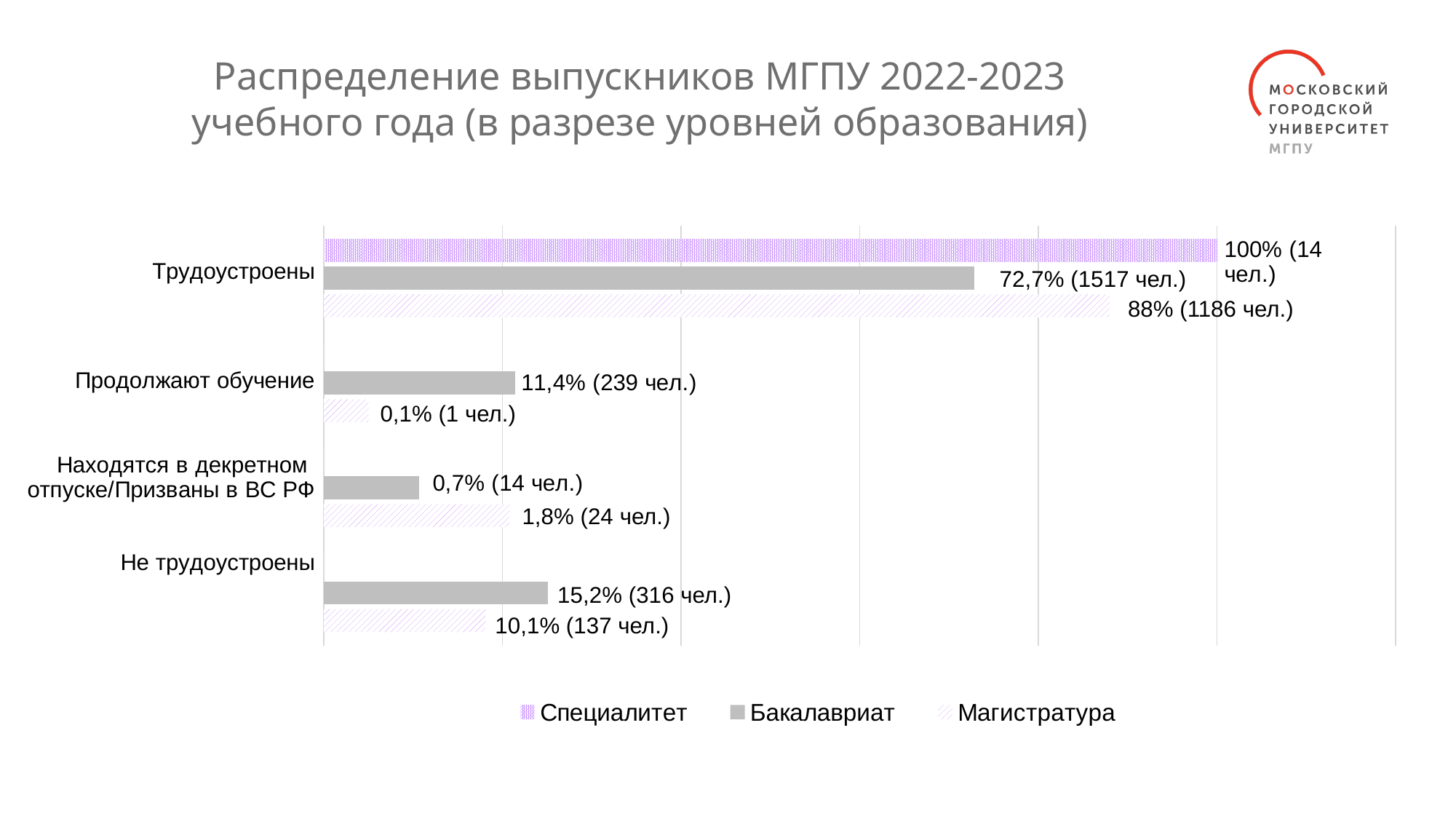
What is the value for Магистратура in the Продолжают обучение category? 0,1% (1 чел.) What is the difference in percentage points between Бакалавриат and Магистратура in the Не трудоустроены category? 5,1 How many categories are shown on the vertical axis of the chart? 4 Which series has the highest percentage in the Трудоустроены category? Специалитет What is the value for Бакалавриат in the Трудоустроены category? 72,7% (1517 чел.) In the Находятся в декретном отпуске/Призваны в ВС РФ category, which is larger: Бакалавриат or Магистратура? Магистратура How many series does the legend list? 3 What kind of chart is shown on the slide? Bar chart What is the value for Магистратура in the Трудоустроены category? 88% (1186 чел.) What is the value for Бакалавриат in the Не трудоустроены category? 15,2% (316 чел.) What is the value for Специалитет in the Трудоустроены category? 100% (14 чел.)